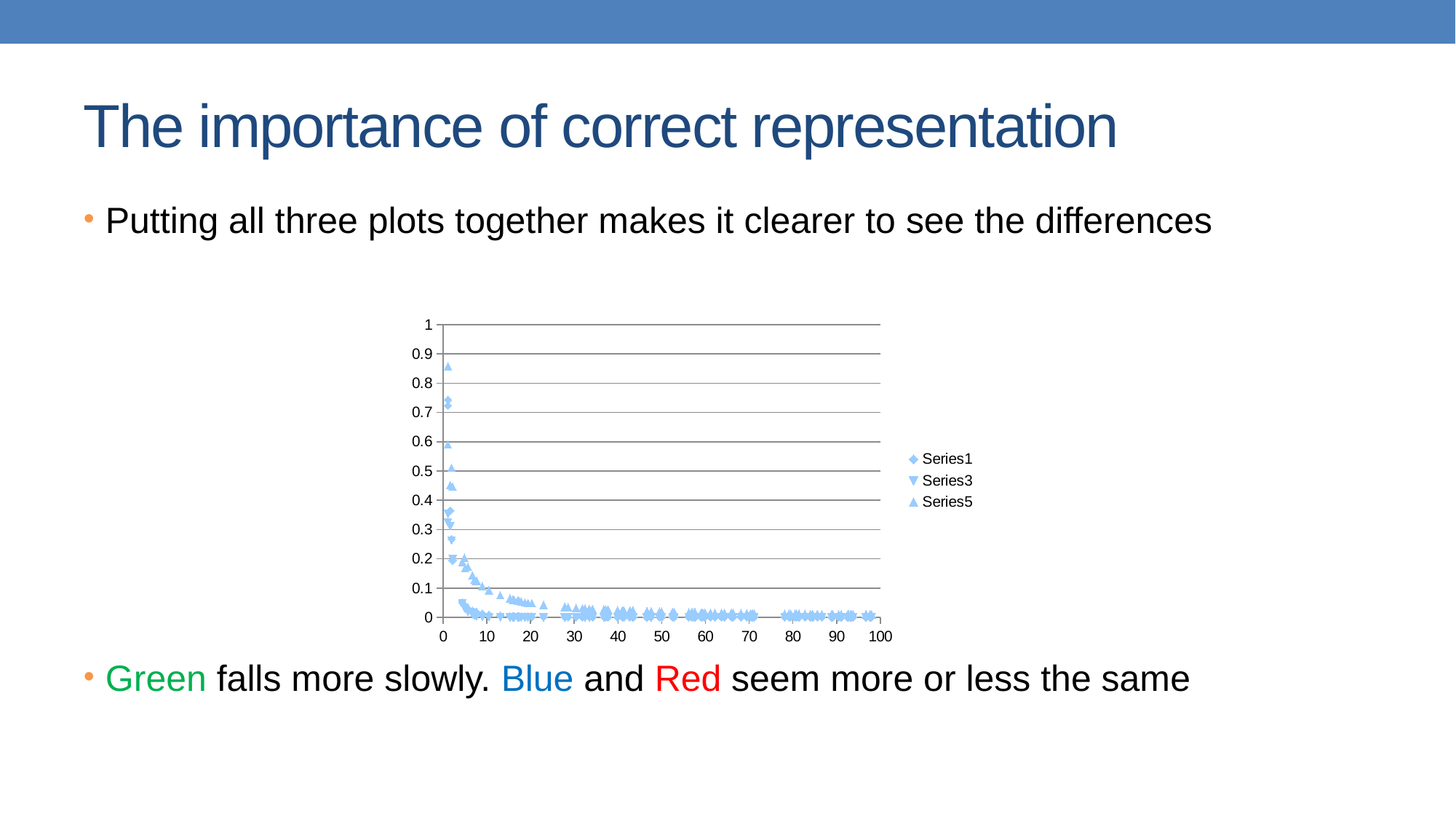
How many series does the chart's legend list? 3 Are the plotted values at x = 50 greater or less than 0.1? less Is the first Series1 point (near x = 1) greater or less than 0.6? greater What kind of chart is shown on the slide? Scatter chart Do the plotted values rise or fall as x increases along the x axis? Fall What are the names of the series listed in the chart's legend? Series1, Series3, Series5 Are the Series5 values around x = 20 greater or less than 0.1? less What is the maximum value shown on the chart's y axis? 1 Which series has the highest plotted value on the chart? Series5